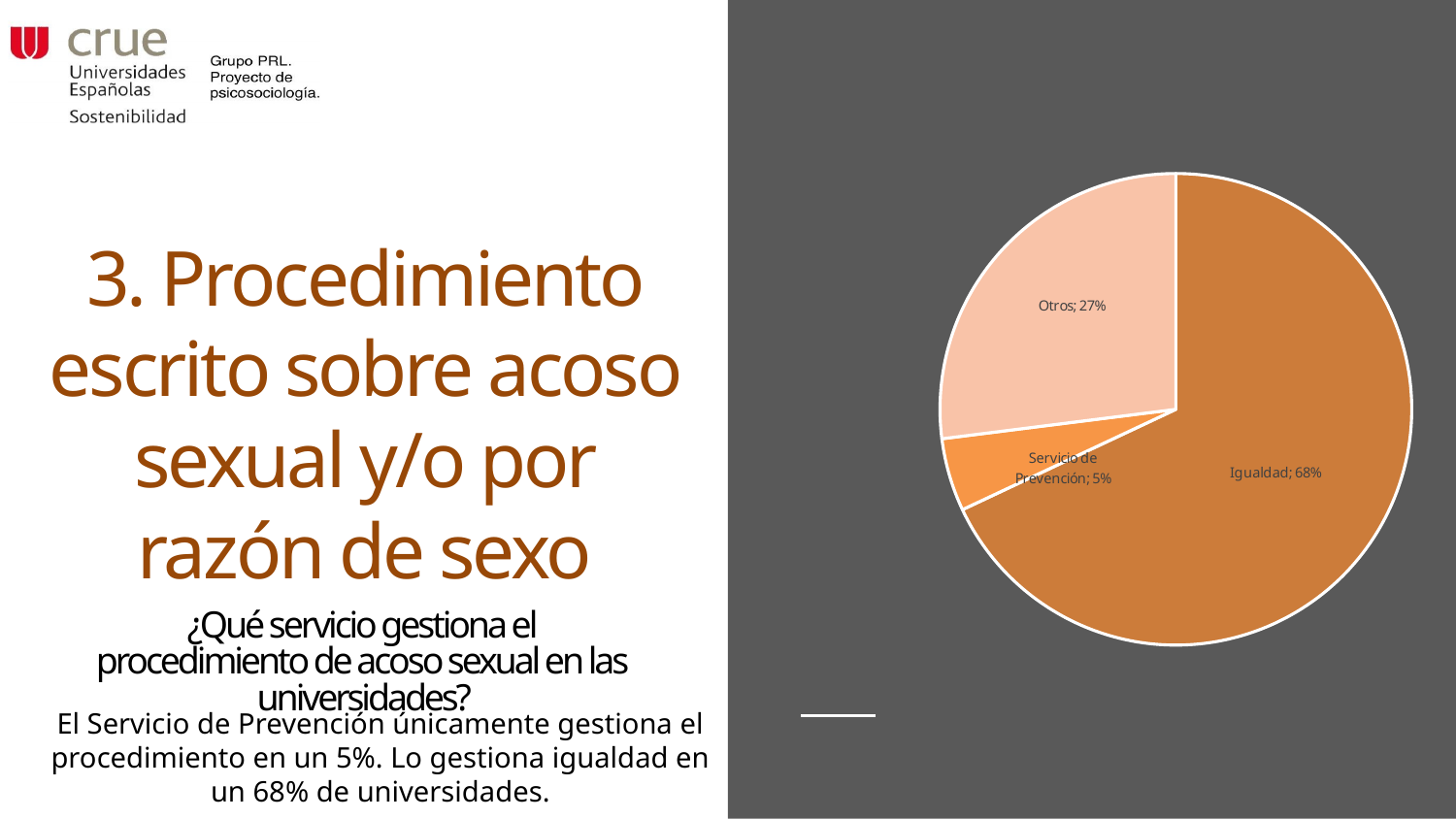
What percentage of the pie chart corresponds to Otros? 27% What percentage of the pie chart corresponds to Igualdad? 68% What is the difference in percentage points between the Igualdad slice and the Otros slice? 41 How many slices does the pie chart have? 3 What percentage of the pie chart corresponds to Servicio de Prevención? 5% What is the difference in percentage points between the Otros slice and the Servicio de Prevención slice? 22 Which slice of the pie chart is drawn in the lightest colour? Otros What kind of chart is shown on the slide? pie chart What share of the pie does the Igualdad slice represent? 68% Which slice of the pie chart is the largest? Igualdad Which slice of the pie chart is the smallest? Servicio de Prevención Which is larger in the pie chart, Otros or Servicio de Prevención? Otros